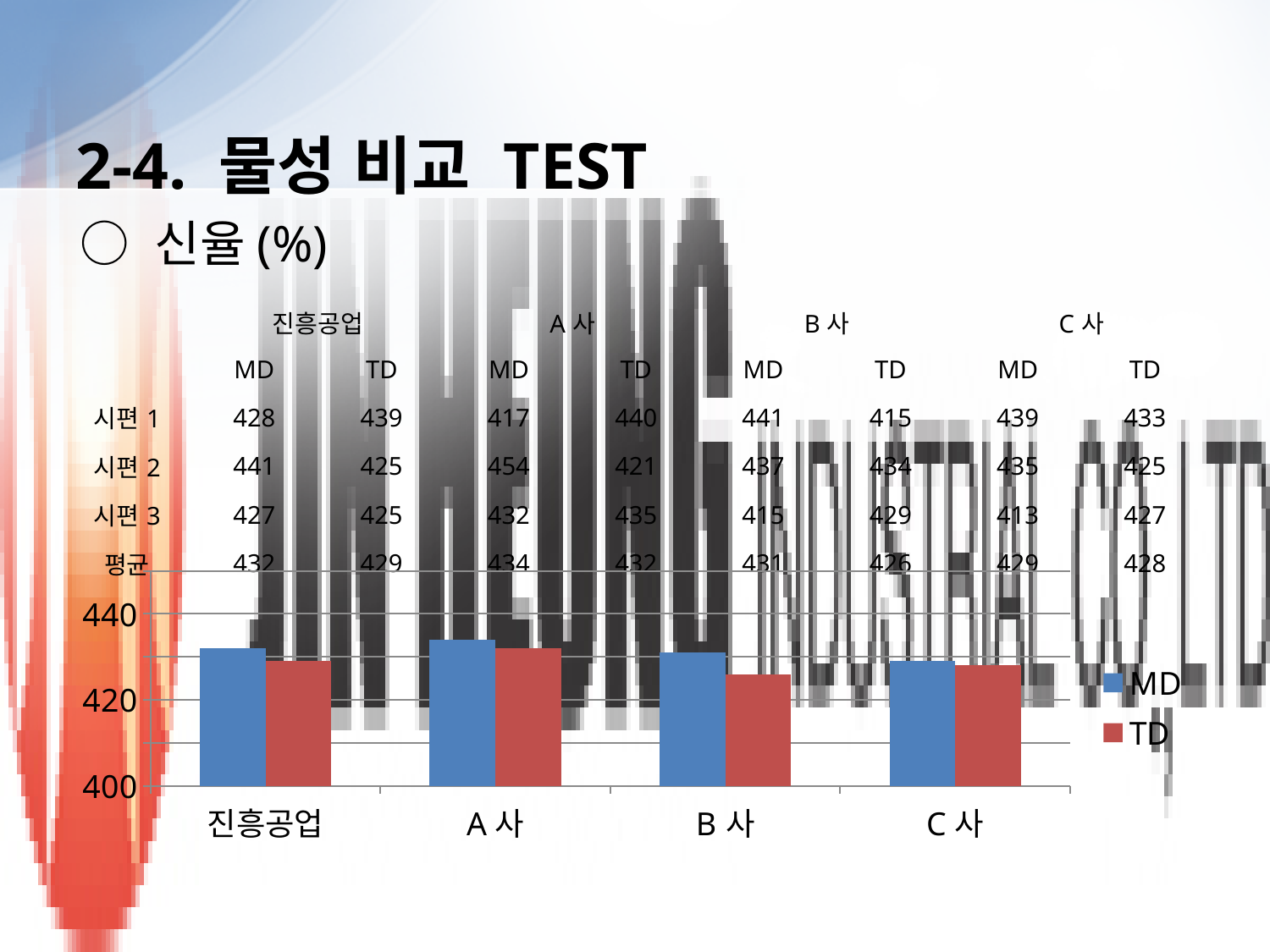
According to the 평균 row of the table above the chart, what is the MD average for B 사? 431 Is the MD value for A 사 greater or less than 440? less Which colour represents the TD series in the chart? red What are the two series named in the chart legend? MD and TD According to the 평균 row of the table above the chart, what is the TD average for 진흥공업? 429 How many categories are shown on the x axis of the chart? 4 Is the TD value for B 사 greater or less than 440? less What kind of chart is shown on the slide? bar chart How many series does the chart legend list? 2 For B 사, which is larger, the MD bar or the TD bar? MD Is the MD value for 진흥공업 greater or less than 420? greater